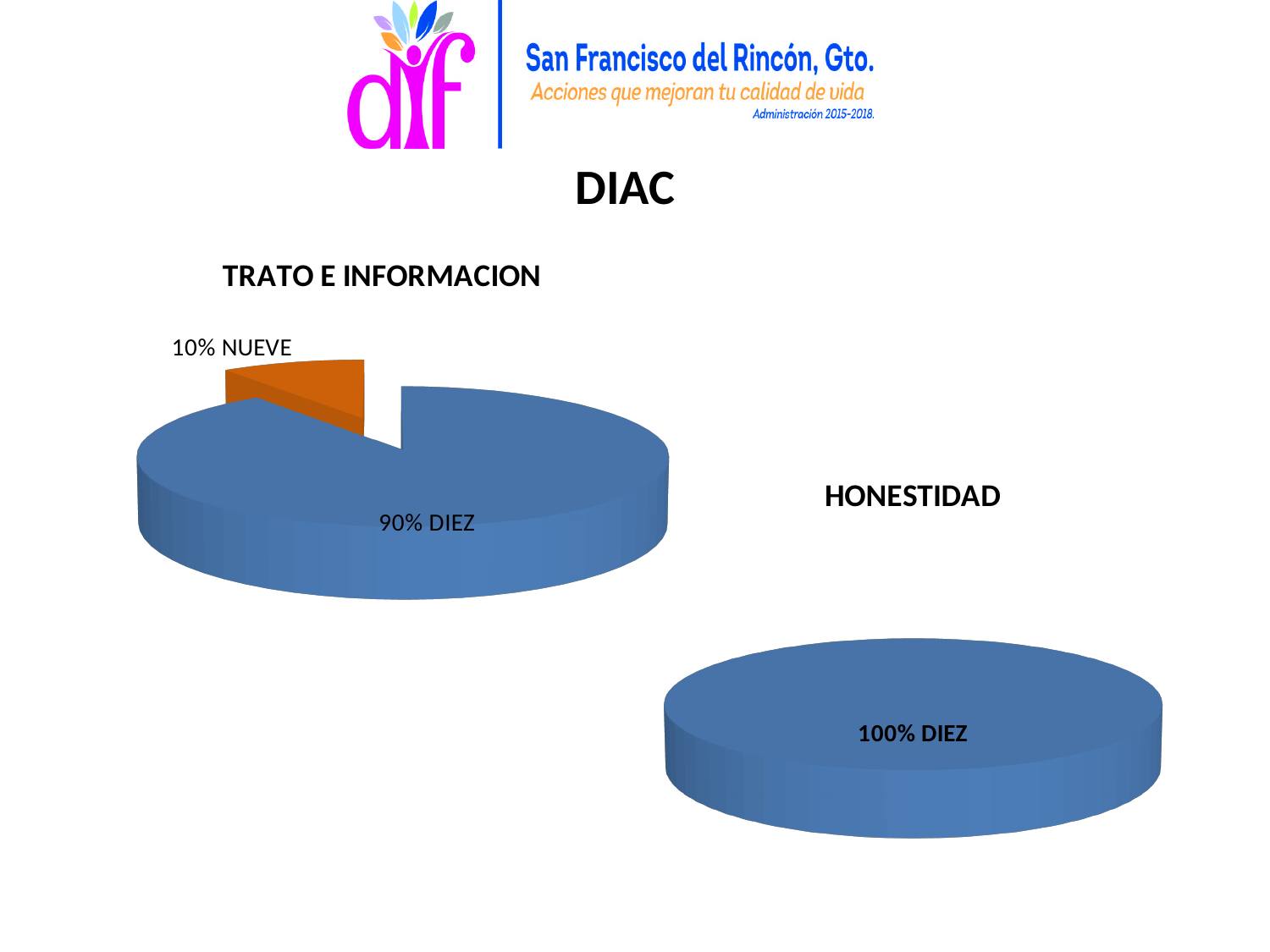
In the TRATO E INFORMACION chart, what share of the pie is labelled DIEZ? 90% In the HONESTIDAD chart, what share of the pie is labelled DIEZ? 100% What kind of chart is the HONESTIDAD chart? Pie chart What kind of chart is the TRATO E INFORMACION chart? Pie chart How many slices does the TRATO E INFORMACION chart have? 2 In the TRATO E INFORMACION chart, what is the difference in percentage points between the DIEZ and NUEVE slices? 80 In the TRATO E INFORMACION chart, which slice is the smallest? NUEVE In the TRATO E INFORMACION chart, what share of the pie is labelled NUEVE? 10% In the TRATO E INFORMACION chart, which slice is larger, DIEZ or NUEVE? DIEZ How many slices does the HONESTIDAD chart have? 1 In the TRATO E INFORMACION chart, what colour is the NUEVE slice? Orange In the TRATO E INFORMACION chart, which slice is the largest? DIEZ